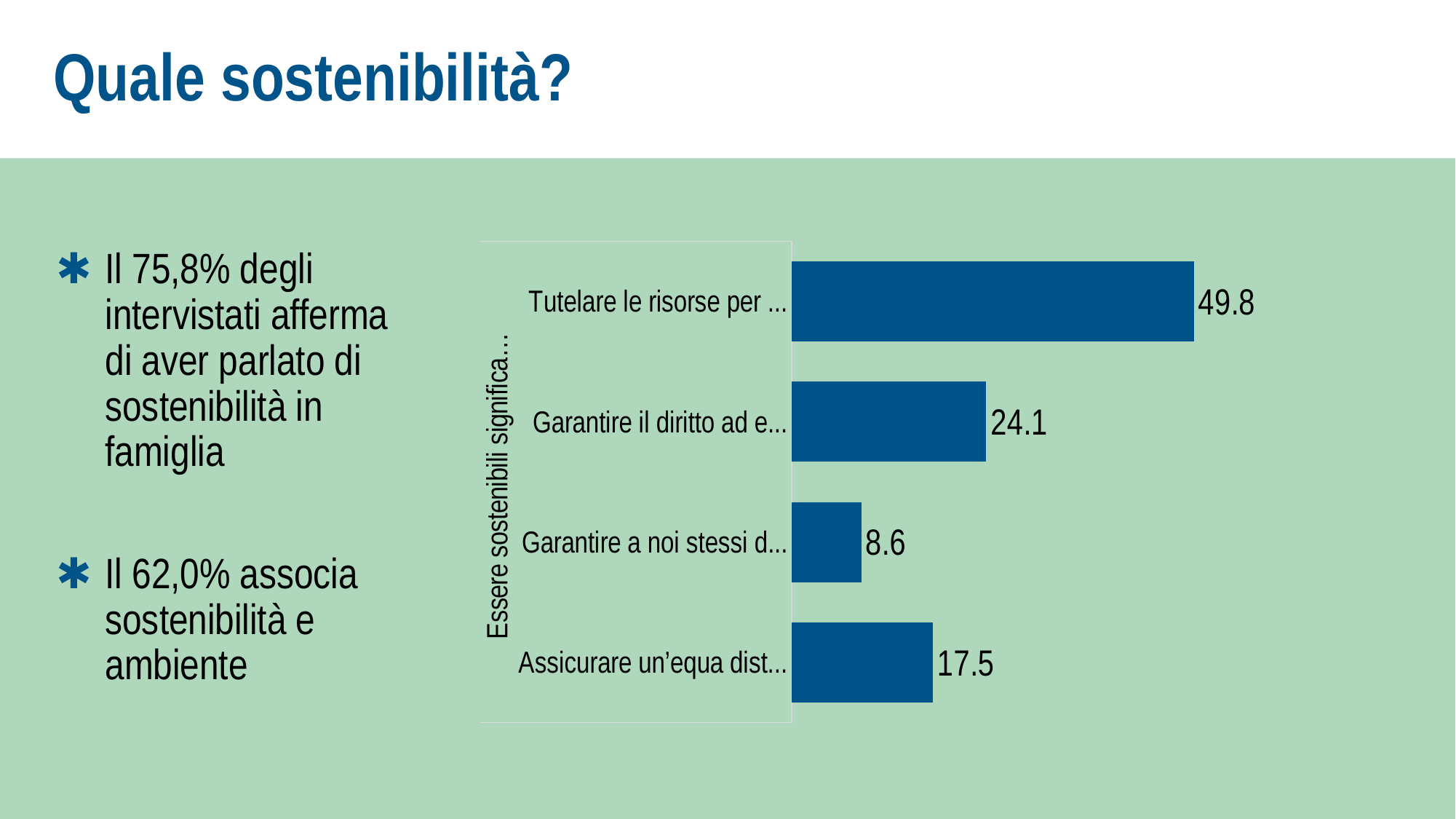
Which category has the lowest value? Garantire a noi stessi d... What is the value for the category labelled "Tutelare le risorse per ..."? 49.8 What is the difference between the values for "Assicurare un'equa dist..." and "Garantire a noi stessi d..."? 8.9 What is the value for the category labelled "Garantire il diritto ad e..."? 24.1 What is the difference between the values for "Tutelare le risorse per ..." and "Garantire il diritto ad e..."? 25.7 What is the value for the category labelled "Assicurare un'equa dist..."? 17.5 Which category has the highest value? Tutelare le risorse per ... What kind of chart is shown on the slide? Bar chart What is the title of the slide? Quale sostenibilità? What is the value for the category labelled "Garantire a noi stessi d..."? 8.6 Which is larger, the value for "Garantire il diritto ad e..." or the value for "Assicurare un'equa dist..."? Garantire il diritto ad e... How many categories are shown in the chart? 4